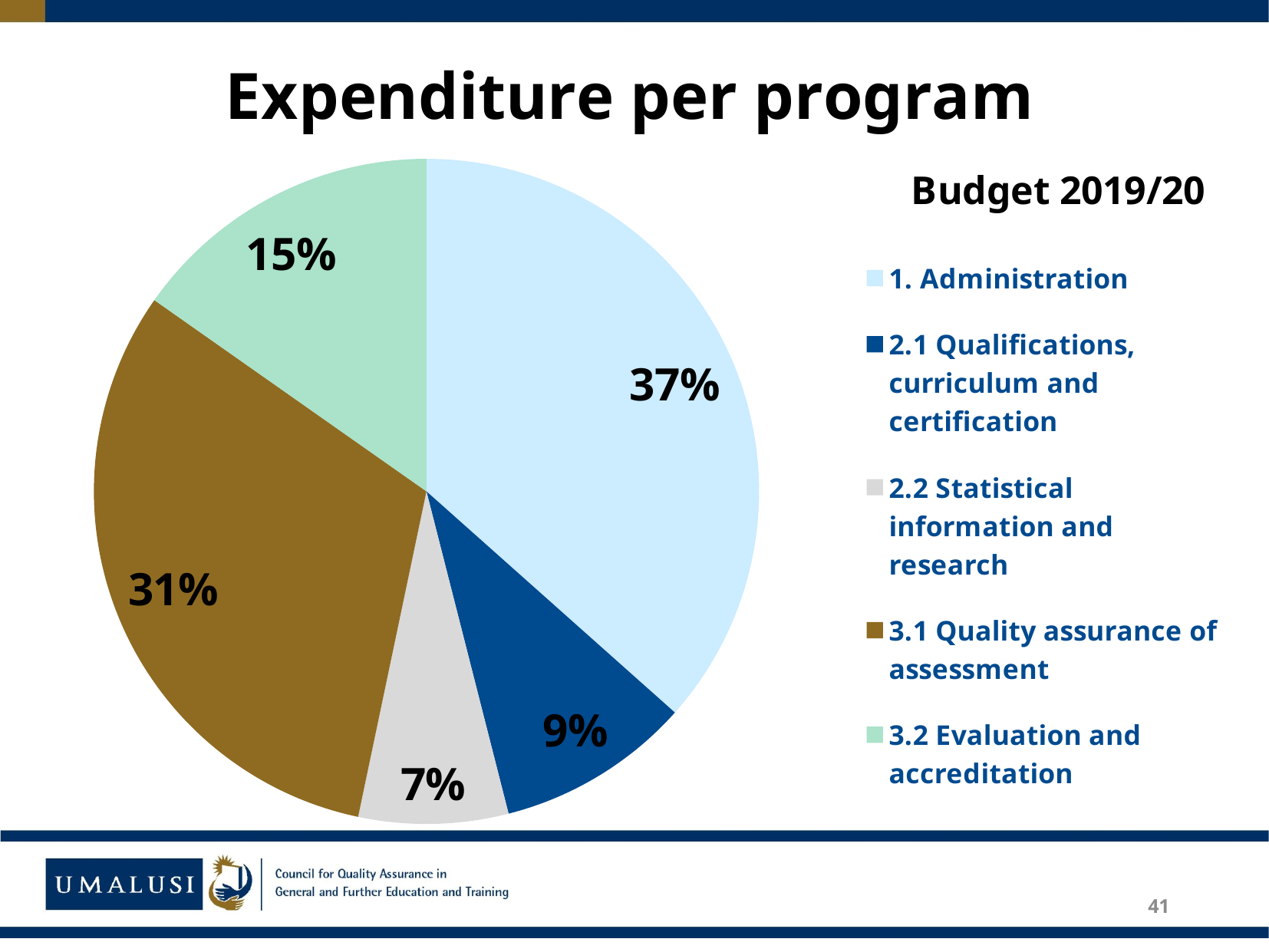
Which program has the smallest share of the budget? 2.2 Statistical information and research What share of the budget goes to 3.2 Evaluation and accreditation? 15% What share of the budget goes to 2.1 Qualifications, curriculum and certification? 9% Which program has the largest share of the budget? 1. Administration What is the difference in percentage points between 1. Administration and 3.1 Quality assurance of assessment? 6 How many programs are shown in the pie chart? 5 What type of chart is shown on the slide? Pie chart What is the title of the chart? Budget 2019/20 Which has a larger share: 3.2 Evaluation and accreditation or 2.1 Qualifications, curriculum and certification? 3.2 Evaluation and accreditation What share of the budget goes to 3.1 Quality assurance of assessment? 31% What share of the budget goes to 1. Administration? 37% What share of the budget goes to 2.2 Statistical information and research? 7%